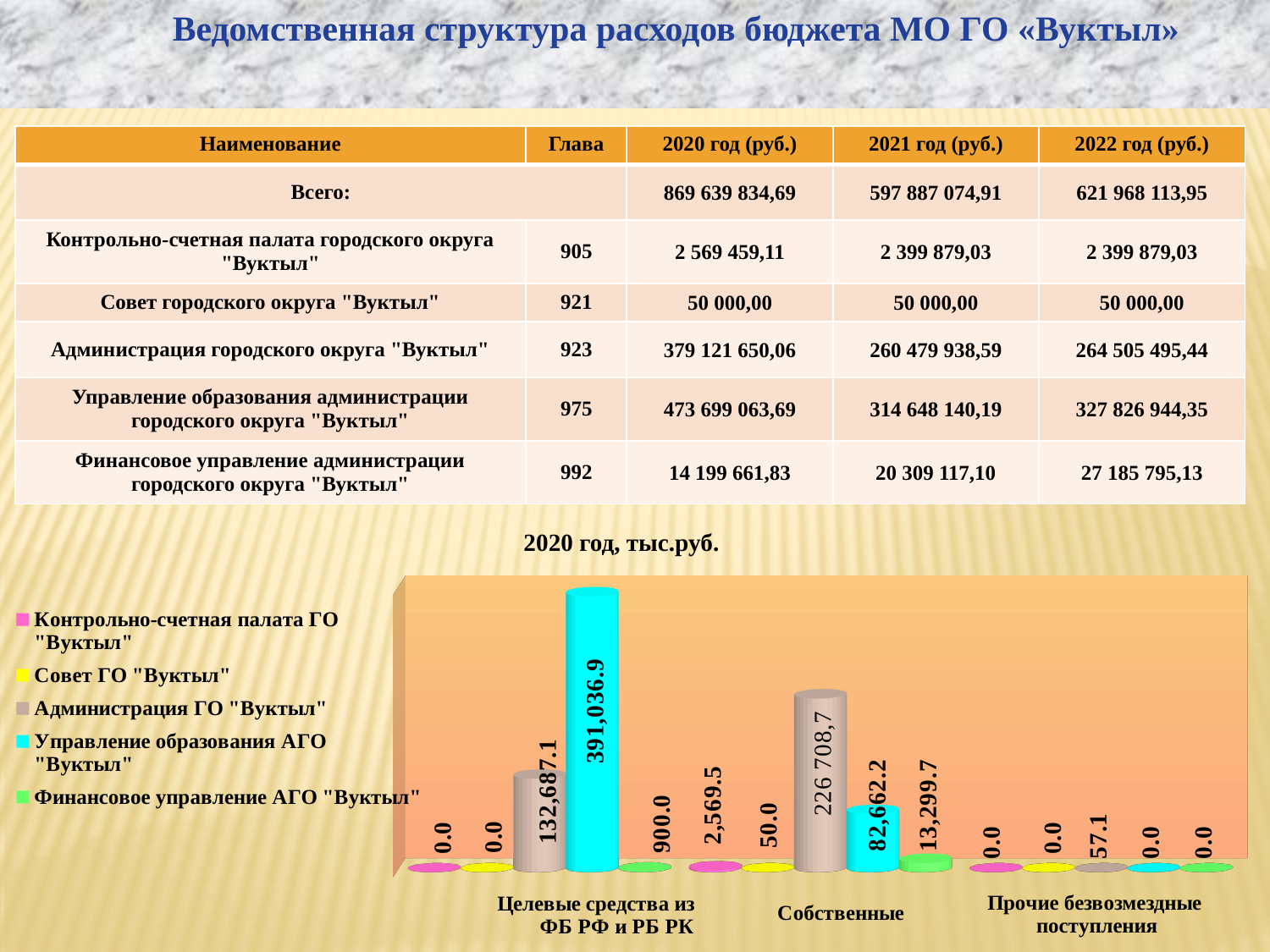
In the chart, which is larger for Управление образования АГО "Вуктыл": the value in Целевые средства из ФБ РФ и РБ РК or the value in Собственные? Целевые средства из ФБ РФ и РБ РК In the chart, what is the value for Финансовое управление АГО "Вуктыл" in the category Собственные? 13,299.7 In the chart, what is the value for Управление образования АГО "Вуктыл" in the category Целевые средства из ФБ РФ и РБ РК? 391,036.9 How many series does the legend of the chart list? 5 In the chart, what is the value for Администрация ГО "Вуктыл" in the category Собственные? 226 708,7 In the chart, which series has the highest value in the category Собственные? Администрация ГО "Вуктыл" In the chart, what is the value for Контрольно-счетная палата ГО "Вуктыл" in the category Собственные? 2,569.5 In the chart, what is the difference between the values for Совет ГО "Вуктыл" and Финансовое управление АГО "Вуктыл" in the category Целевые средства из ФБ РФ и РБ РК? 900.0 How many categories are shown along the x axis of the chart? 3 In the chart, what is the value for Администрация ГО "Вуктыл" in the category Прочие безвозмездные поступления? 57.1 What kind of chart is shown under the title "2020 год, тыс.руб."? bar chart In the chart, which series has the highest value in the category Целевые средства из ФБ РФ и РБ РК? Управление образования АГО "Вуктыл"